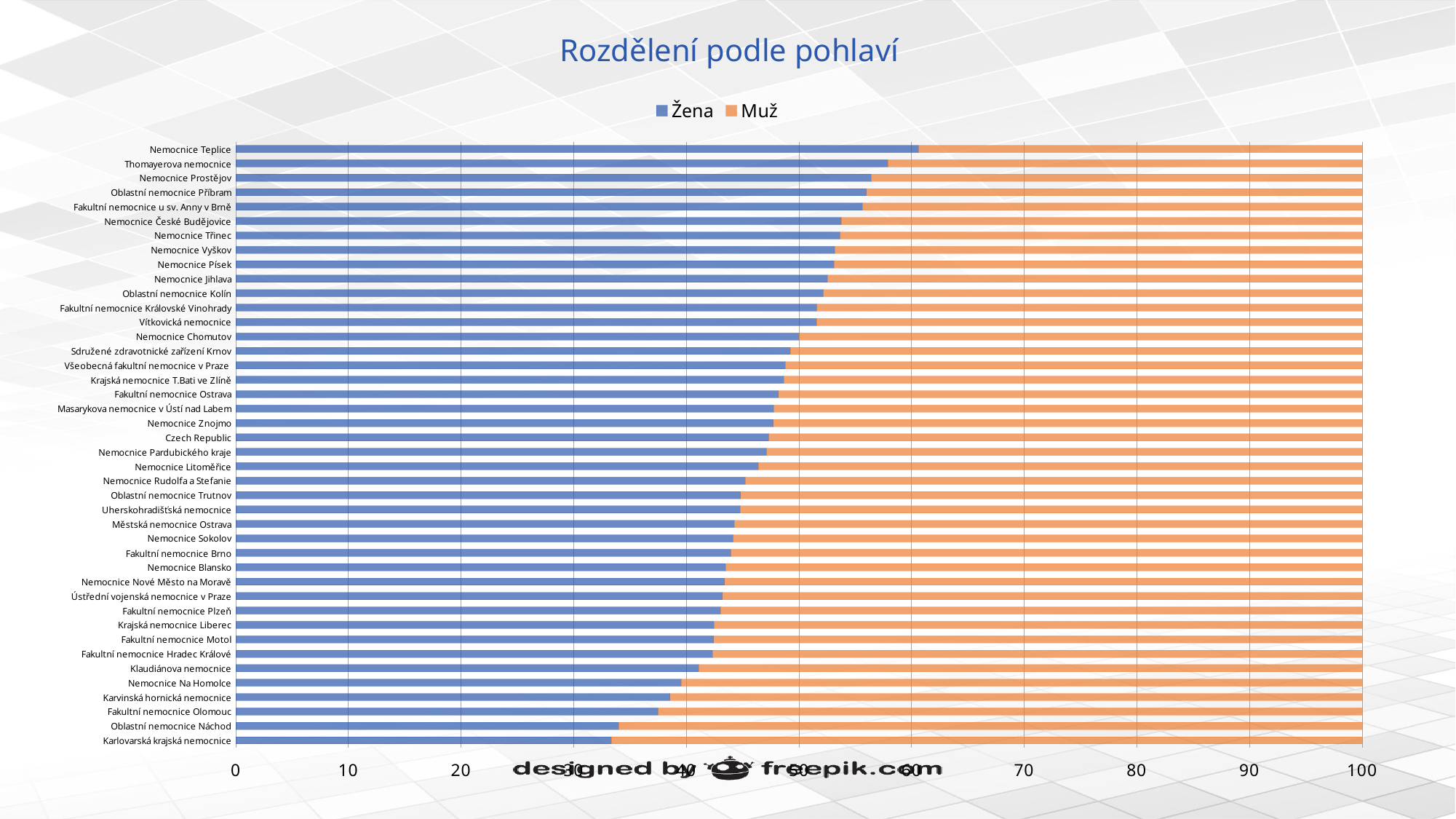
What is the title of the chart? Rozdělení podle pohlaví Is the Žena value for Fakultní nemocnice Olomouc greater or less than 40? less How many series does the legend list? 2 Which series is shown in orange? Muž What kind of chart is shown on the slide? bar chart Which category has the highest Žena share? Nemocnice Teplice Is the Žena value for Nemocnice Teplice greater or less than 50? greater How many hospitals (categories) are plotted on the chart? 42 Is the Muž value for Karlovarská krajská nemocnice greater or less than 60? greater Which has the larger Žena share, Nemocnice Teplice or Oblastní nemocnice Náchod? Nemocnice Teplice